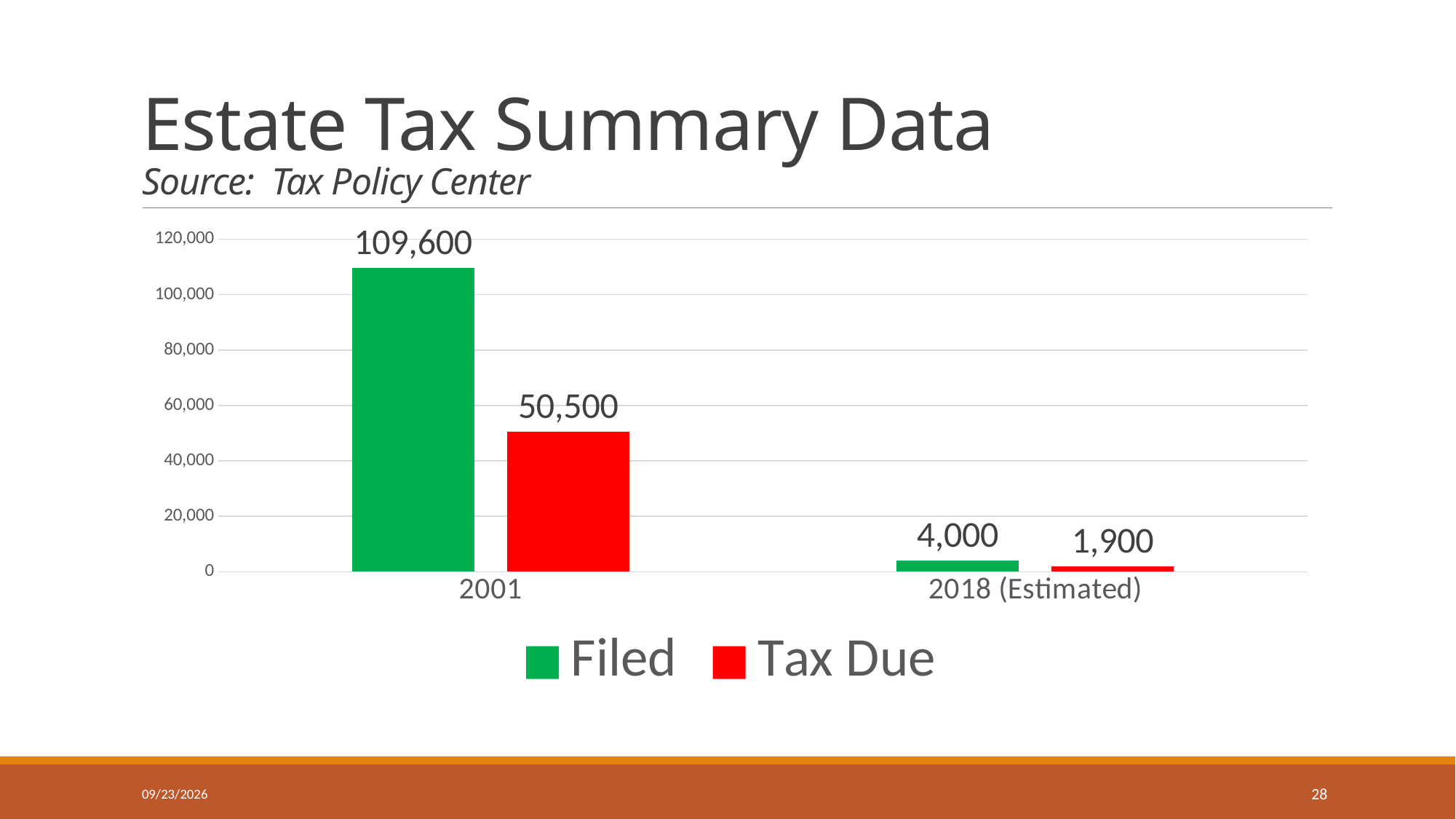
What is the value for Filed in 2001? 109,600 What is the value for Filed in 2018 (Estimated)? 4,000 How many categories are shown on the x axis? 2 How many series does the legend list? 2 Which category has the lowest Tax Due value? 2018 (Estimated) What is the difference between the Filed and Tax Due values in 2001? 59,100 What is the difference between the Filed values for 2001 and 2018 (Estimated)? 105,600 Which is larger: Filed in 2018 (Estimated) or Tax Due in 2018 (Estimated)? Filed in 2018 (Estimated) What is the value for Tax Due in 2001? 50,500 Which category has the highest Filed value? 2001 What is the value for Tax Due in 2018 (Estimated)? 1,900 What kind of chart is shown on the slide? Bar chart